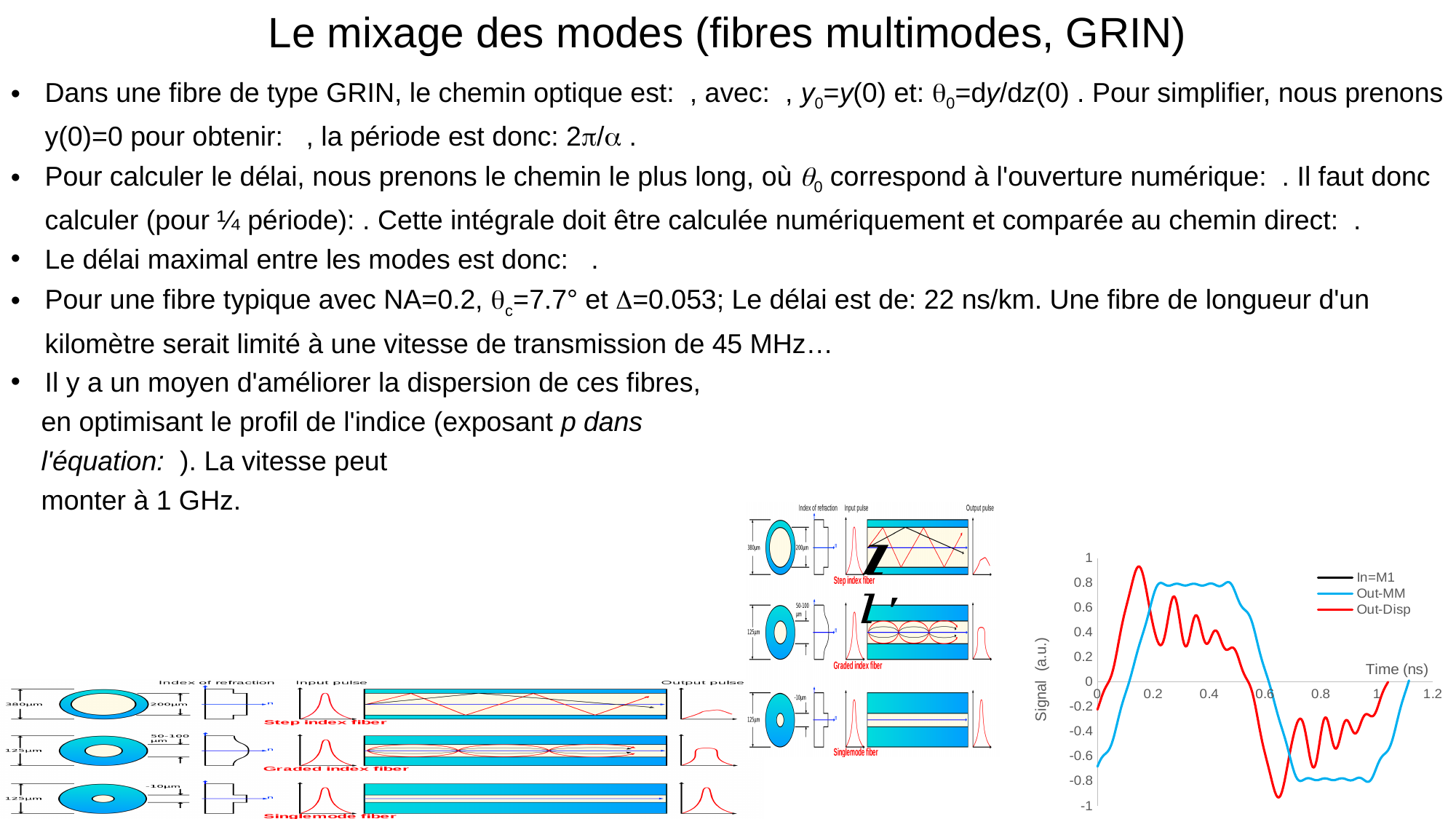
In the chart on the right, is the value of Out-Disp at time 0 greater or less than -0.4? greater What is the x-axis title of the chart on the right? Time (ns) In the chart on the right, is the value of Out-Disp at 0.4 ns greater or less than 0.2? greater What are the series names in the legend of the chart on the right? In=M1, Out-MM, Out-Disp What kind of chart is shown on the right of the slide? line chart In the chart on the right, is the peak value of the Out-Disp series greater or less than 0.8? greater How many series does the legend of the chart on the right list? 3 In the chart on the right, which series is drawn in red? Out-Disp